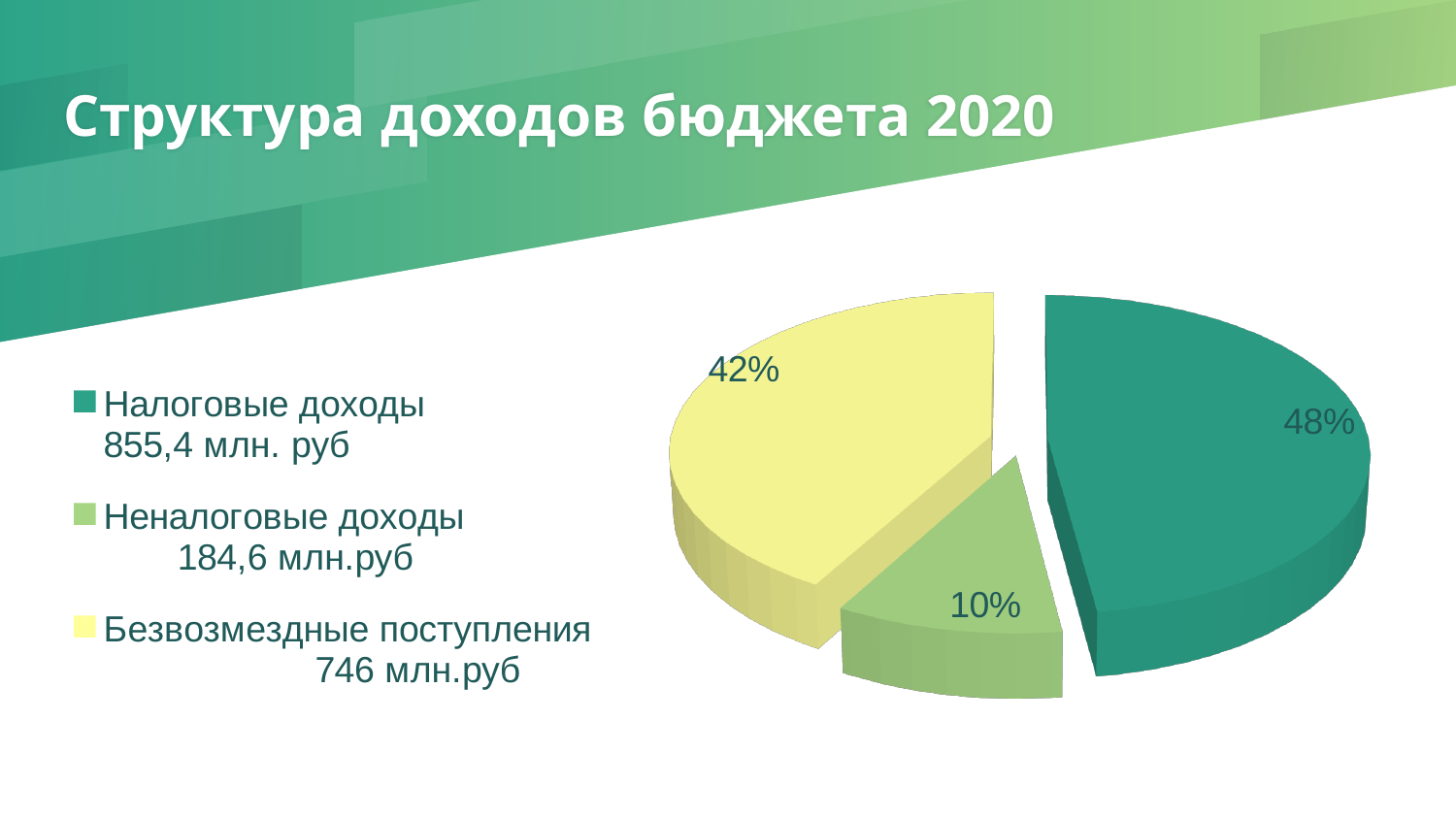
What share of the pie does Неналоговые доходы represent? 10% How many entries does the legend list? 3 Which slice is larger: Безвозмездные поступления or Неналоговые доходы? Безвозмездные поступления What is the difference in percentage points between the Налоговые доходы slice and the Безвозмездные поступления slice? 6 What kind of chart is shown on the slide? pie chart How many slices does the pie chart have? 3 What amount in млн. руб is shown in the legend for Безвозмездные поступления? 746 млн.руб What share of the pie does Безвозмездные поступления represent? 42% Which category has the largest slice of the pie? Налоговые доходы What share of the pie does Налоговые доходы represent? 48% What is the title of the slide? Структура доходов бюджета 2020 Which category has the smallest slice of the pie? Неналоговые доходы